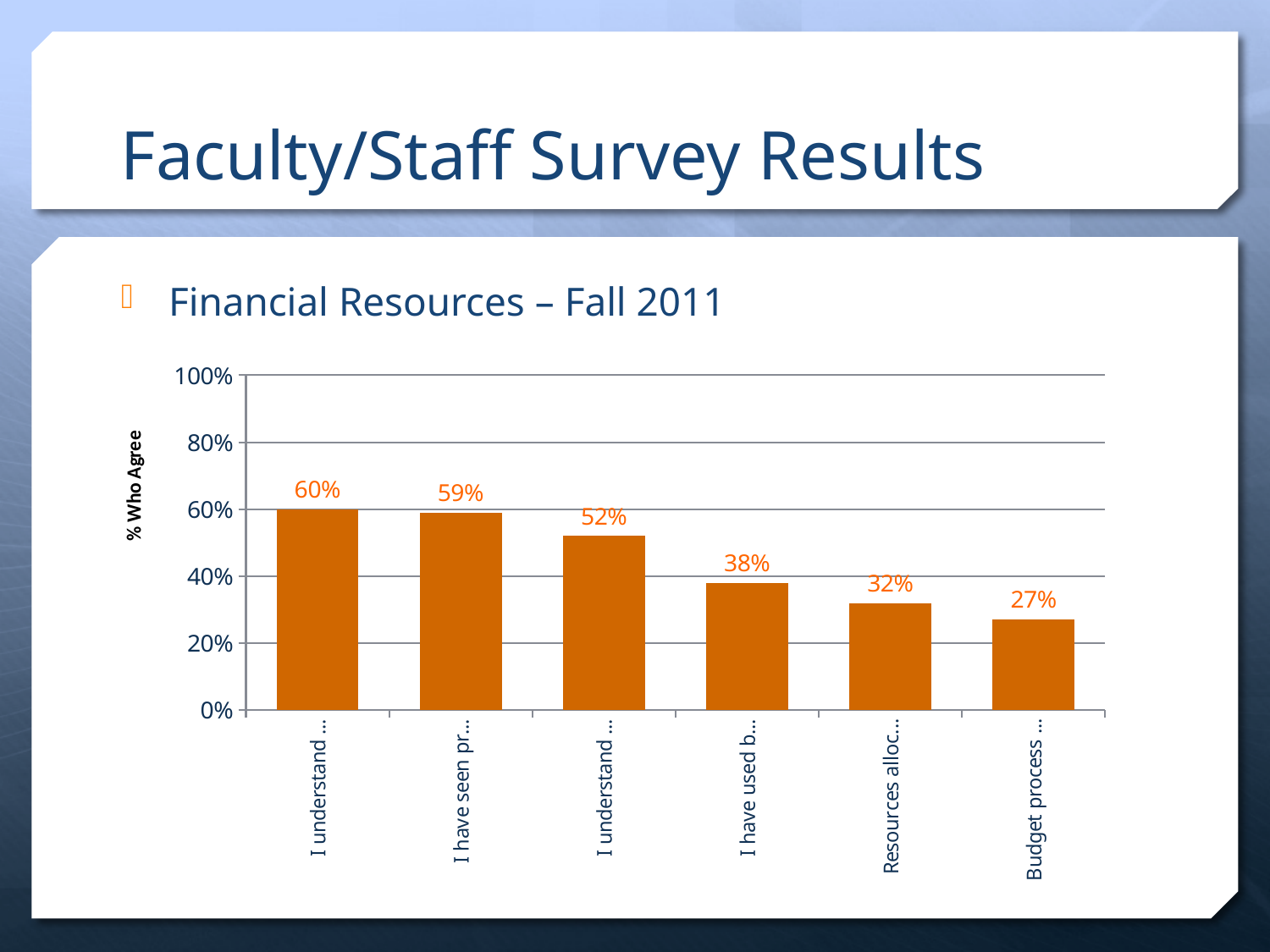
What is the label on the vertical axis of the chart? % Who Agree Which bar has the lowest value in the chart? Budget process ... What is the value for the category labelled "I have seen pr..."? 59% How many bars are plotted in the chart? 6 What is the value for the category labelled "Budget process ..."? 27% What type of chart is shown on the slide? bar chart What is the value for the category labelled "Resources alloc..."? 32% Do the bar values rise or fall from left to right across the chart? fall What is the difference between the value for "I have used b..." and the value for "Budget process ..."? 11% Which is larger: the value for "I have seen pr..." or the value for "Resources alloc..."? I have seen pr... What is the value of the first (leftmost) bar in the chart? 60% What is the value for the category labelled "I have used b..."? 38%